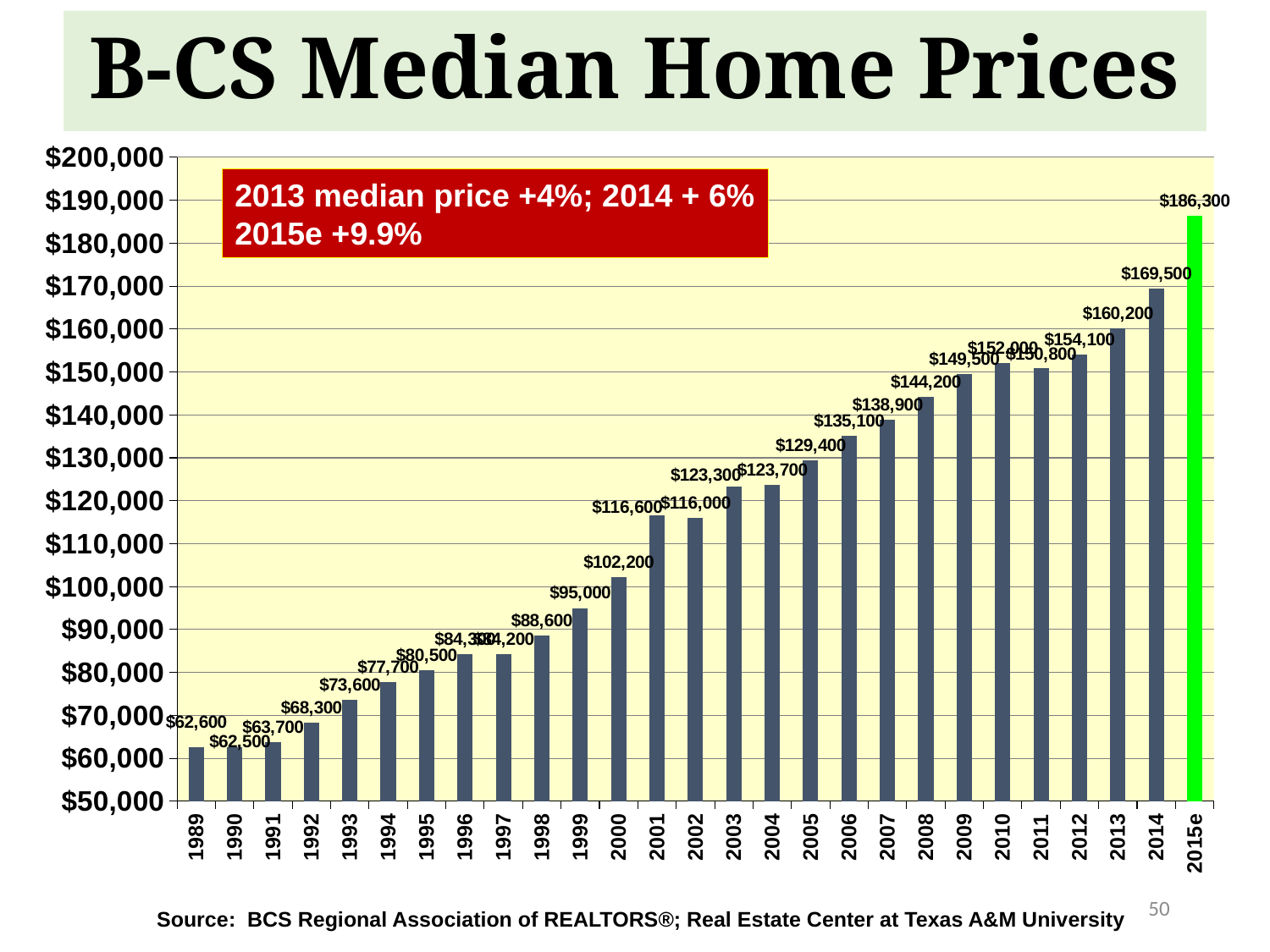
What is the difference between the 2015e and 2014 median home prices? $16,800 Is the median home price for 2006 greater or less than $130,000? greater What is the median home price shown for 2008? $144,200 Which year has the larger median home price, 2005 or 2008? 2008 Which year has the highest median home price on the chart? 2015e Do median home prices generally rise or fall from 1989 to 2015e? Rise What kind of chart is used to show the median home prices? Bar chart How many years (bars) are shown on the chart? 27 What colour is the bar for 2015e? Green What is the median home price shown for 2000? $102,200 What is the difference between the 2014 and 2013 median home prices? $9,300 What is the median home price shown for 2014? $169,500